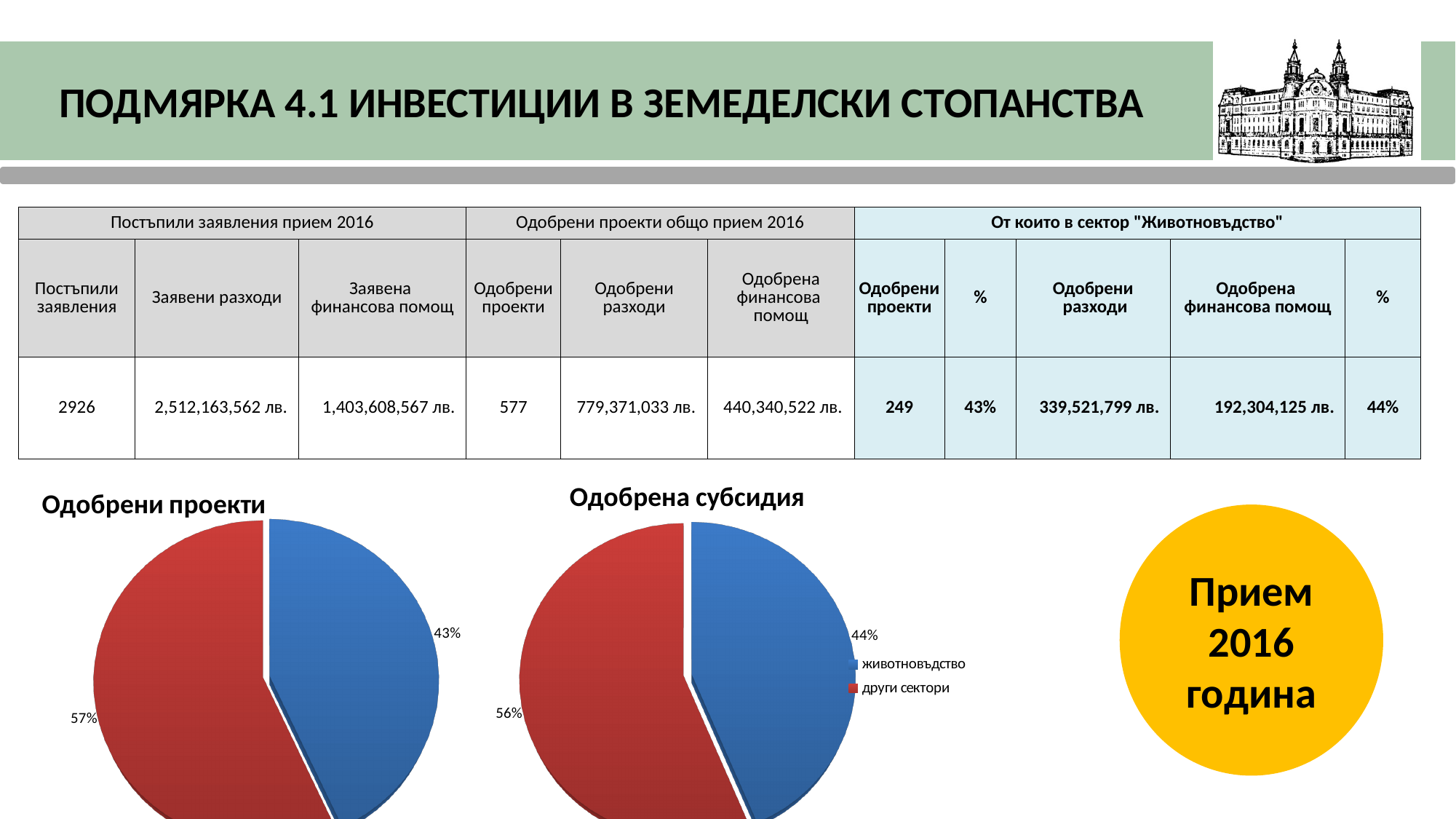
In the "Одобрена субсидия" pie chart, what share does the "други сектори" slice have? 56% What colour is the "други сектори" slice in the pie charts? red In the "Одобрена субсидия" pie chart, which slice is the smallest? животновъдство Which is larger: the "животновъдство" share in the "Одобрени проекти" chart or in the "Одобрена субсидия" chart? Одобрена субсидия In the "Одобрени проекти" pie chart, what share does the "други сектори" slice have? 57% In the "Одобрени проекти" pie chart, what is the difference in percentage points between the "други сектори" and "животновъдство" slices? 14 What kind of chart is the "Одобрени проекти" chart? pie chart In the "Одобрени проекти" pie chart, what share does the "животновъдство" slice have? 43% How many slices does the "Одобрена субсидия" pie chart have? 2 In the "Одобрена субсидия" pie chart, what is the difference in percentage points between the "други сектори" and "животновъдство" slices? 12 In the "Одобрени проекти" pie chart, which slice is the largest? други сектори